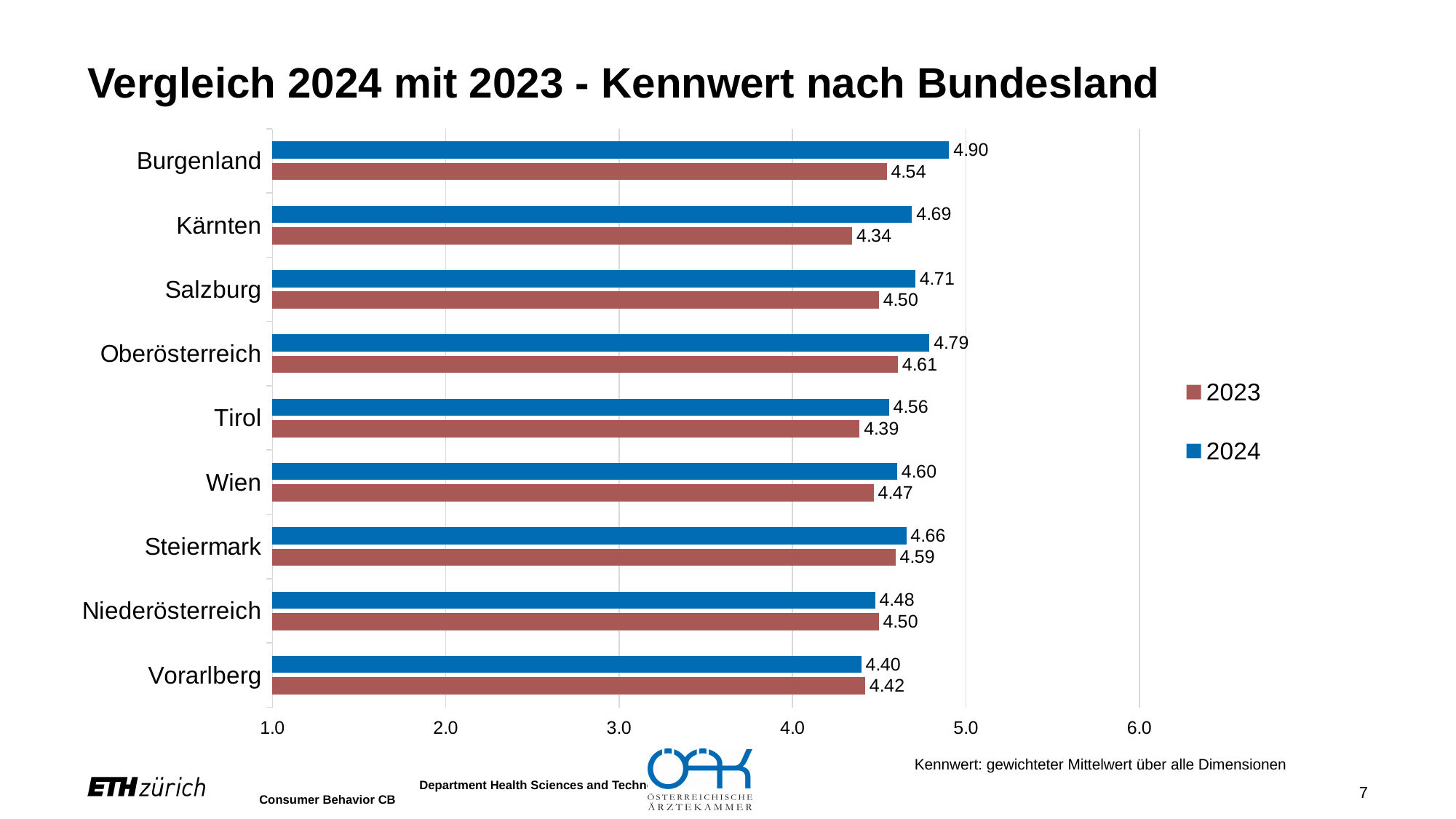
Which Bundesland has the highest 2024 value? Burgenland What is the 2023 value for Steiermark? 4.59 What is the difference between the 2024 and 2023 values for Burgenland? 0.36 What is the 2023 value for Kärnten? 4.34 How many Bundesländer are shown on the chart? 9 How many series does the legend list? 2 Which is larger for Niederösterreich, the 2023 value or the 2024 value? 2023 Which Bundesland has the lowest 2023 value? Kärnten Which Bundesland has the lowest 2024 value? Vorarlberg What kind of chart is shown on the slide? bar chart What is the 2024 value for Burgenland? 4.90 Is the 2023 value for Kärnten greater or less than 5.0? less